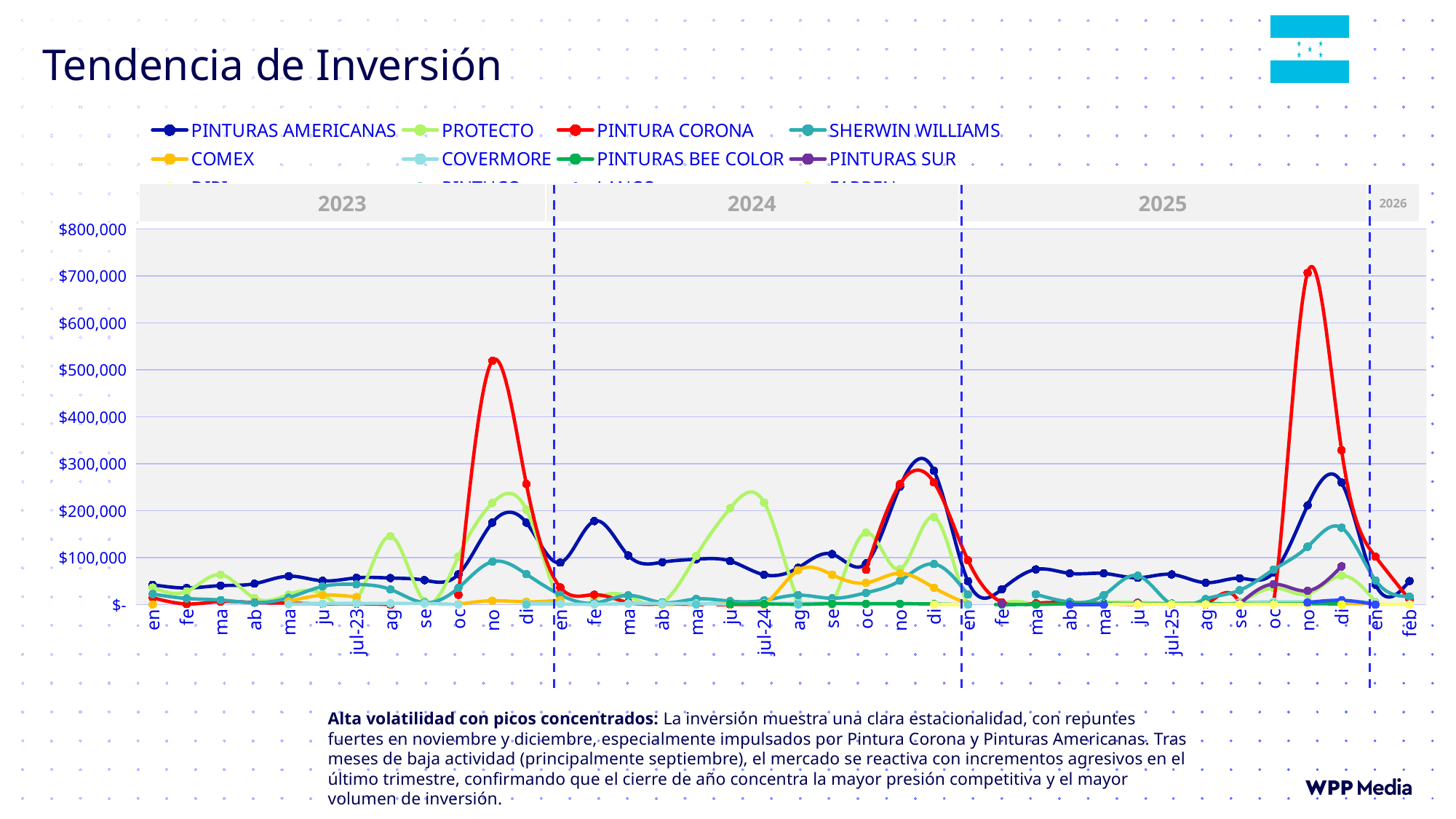
Is the value for PINTURAS AMERICANAS in September 2025 greater or less than $100,000? less What kind of chart is shown on the slide? line chart What is the highest value shown on the vertical axis? $800,000 Does the value for PINTURA CORONA rise or fall from November 2025 to February 2026? fall Is the value for PINTURAS AMERICANAS in December 2025 greater or less than $200,000? greater Is the value for PINTURA CORONA in November 2025 greater or less than $600,000? greater In November 2025, which is larger: PINTURA CORONA or PINTURAS AMERICANAS? PINTURA CORONA What is the title of the chart? Tendencia de Inversión Which series reaches the highest value anywhere on the chart? PINTURA CORONA In July 2024, which is larger: PROTECTO or PINTURAS AMERICANAS? PROTECTO How many year bands are labelled across the top of the chart? 4